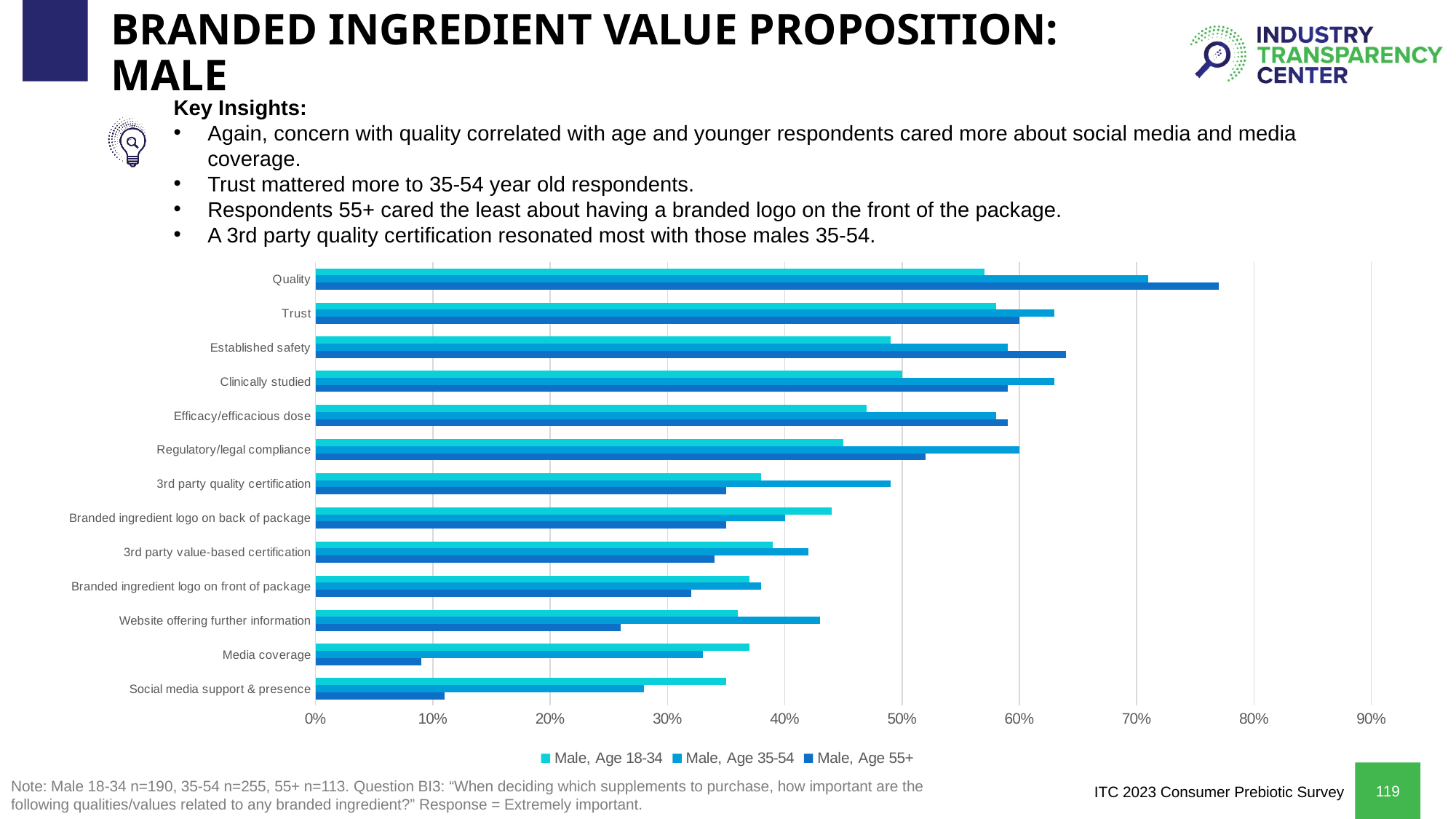
Is the value for Media coverage among Male, Age 55+ greater or less than 20%? less What kind of chart is shown on the slide? Bar chart Which category has the lowest value for Male, Age 35-54? Social media support & presence Is the value for Quality among Male, Age 55+ greater or less than 70%? greater What is the highest tick label shown on the x axis? 90% How many categories are plotted on the y axis of the chart? 13 For Media coverage, which is larger: the value for Male, Age 18-34 or Male, Age 55+? Male, Age 18-34 What are the three series listed in the chart legend? Male, Age 18-34; Male, Age 35-54; Male, Age 55+ Which category has the highest value for Male, Age 55+? Quality Is the value for Website offering further information among Male, Age 55+ greater or less than 30%? less For Quality, which is larger: the value for Male, Age 18-34 or Male, Age 55+? Male, Age 55+ How many series does the legend list? 3